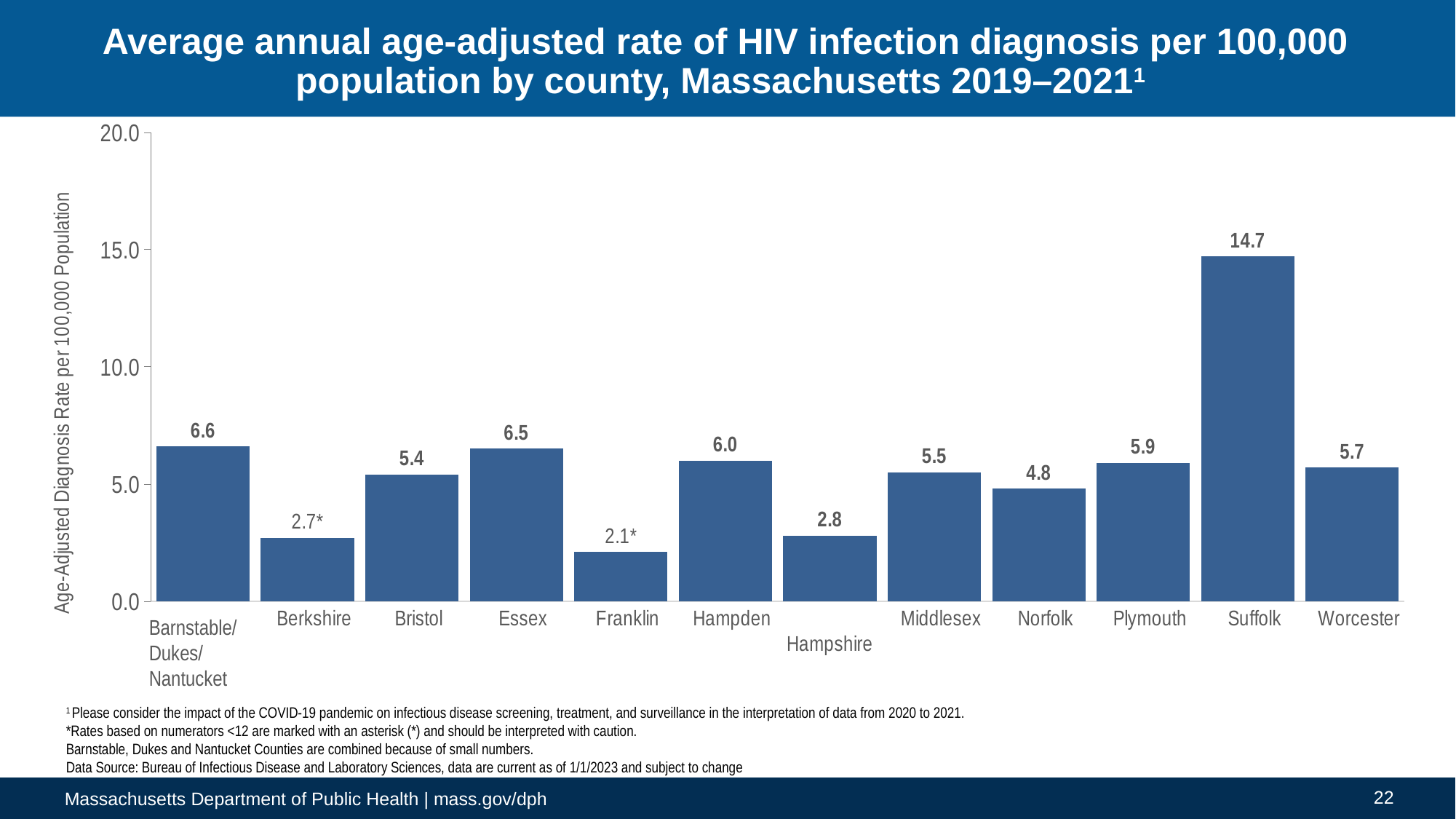
Which counties are combined into a single bar because of small numbers? Barnstable, Dukes and Nantucket Which county has the highest age-adjusted HIV diagnosis rate? Suffolk What kind of chart is shown on the slide? Bar chart What value is shown for Franklin county? 2.1* What is the age-adjusted HIV diagnosis rate for Hampden county? 6.0 How many counties or county groups are shown on the x axis? 12 Is the value for Norfolk greater or less than 5.0? less What is the difference between the rates for Suffolk and Worcester? 9.0 Which has a higher rate, Essex or Bristol? Essex Which county has the lowest age-adjusted HIV diagnosis rate? Franklin What is the age-adjusted HIV diagnosis rate for Suffolk county? 14.7 What is the label of the y axis? Age-Adjusted Diagnosis Rate per 100,000 Population